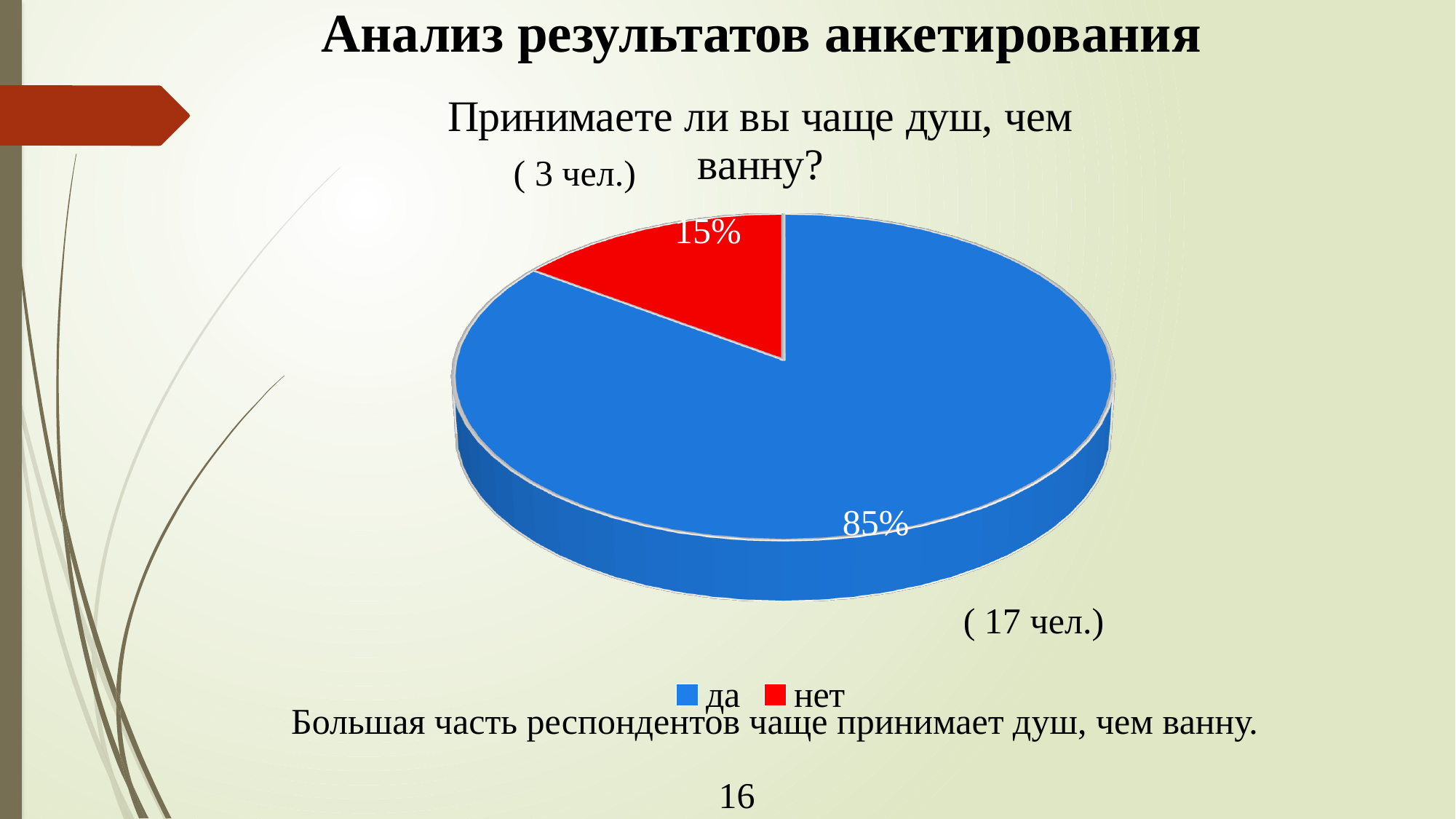
Which slice is larger, "да" or "нет"? да What percentage of respondents answered "да"? 85% What colour is the "нет" slice? red What is the difference in percentage points between the "да" and "нет" slices? 70 How many people answered "нет" according to the annotation on the slide? 3 чел. What percentage of respondents answered "нет"? 15% Which answer has the largest share of the pie? да How many entries does the legend list? 2 How many people answered "да" according to the annotation on the slide? 17 чел. How many categories does the pie chart have? 2 What kind of chart is shown on the slide? pie chart Which answer has the smallest share of the pie? нет